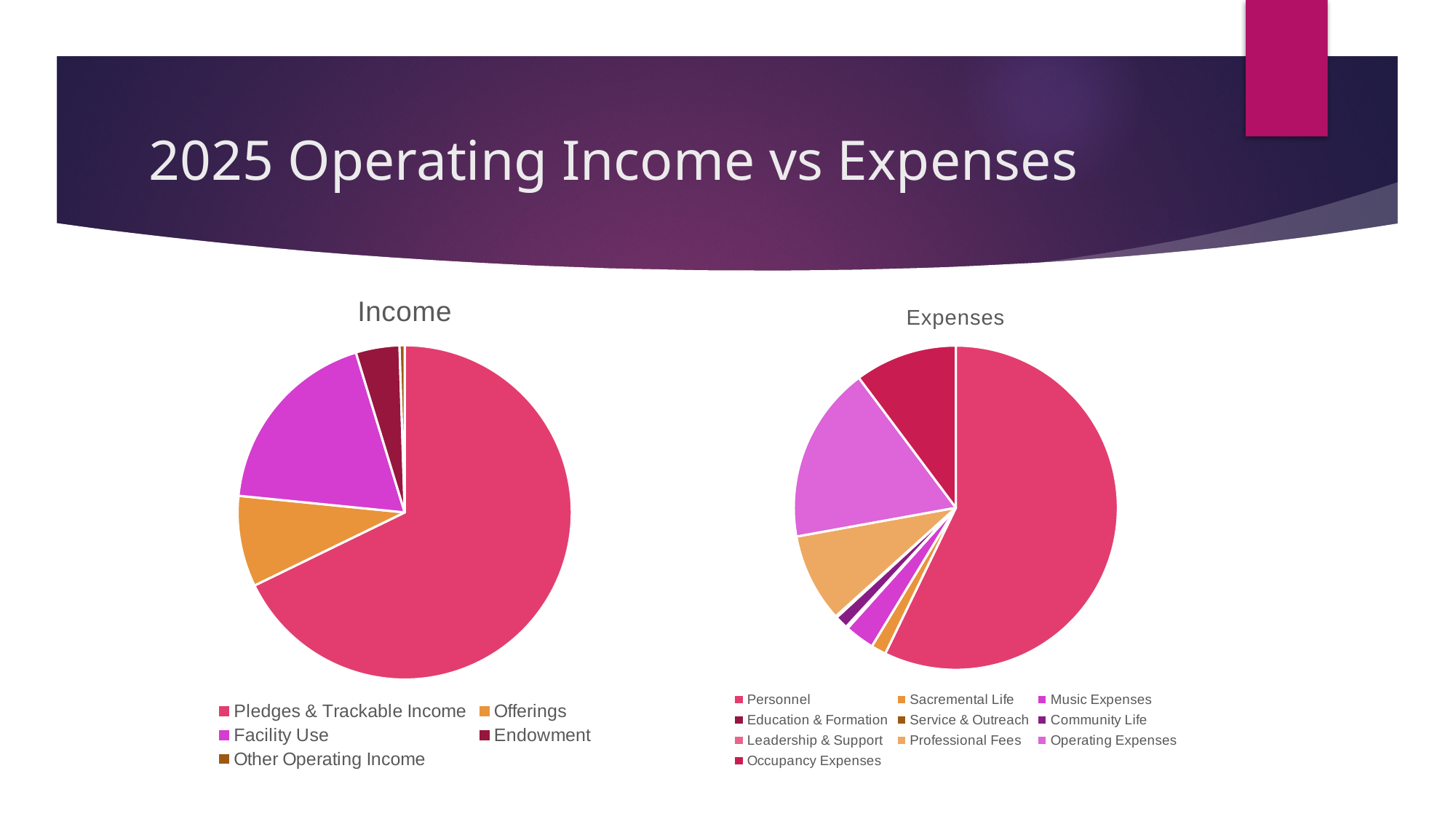
In the Income chart, which slice is larger, Facility Use or Offerings? Facility Use How many categories does the legend of the Expenses chart list? 10 What kind of chart is the Income chart? pie chart In the Income chart, which category has the largest slice? Pledges & Trackable Income In the Expenses chart, which slice is larger, Operating Expenses or Occupancy Expenses? Operating Expenses In the Income chart, which category has the smallest slice? Other Operating Income What is the title of the slide containing the two pie charts? 2025 Operating Income vs Expenses In the Expenses chart, which slice is larger, Sacramental Life or Music Expenses? Music Expenses In the Expenses chart, which category has the largest slice? Personnel How many categories does the legend of the Income chart list? 5 What kind of chart is the Expenses chart? pie chart